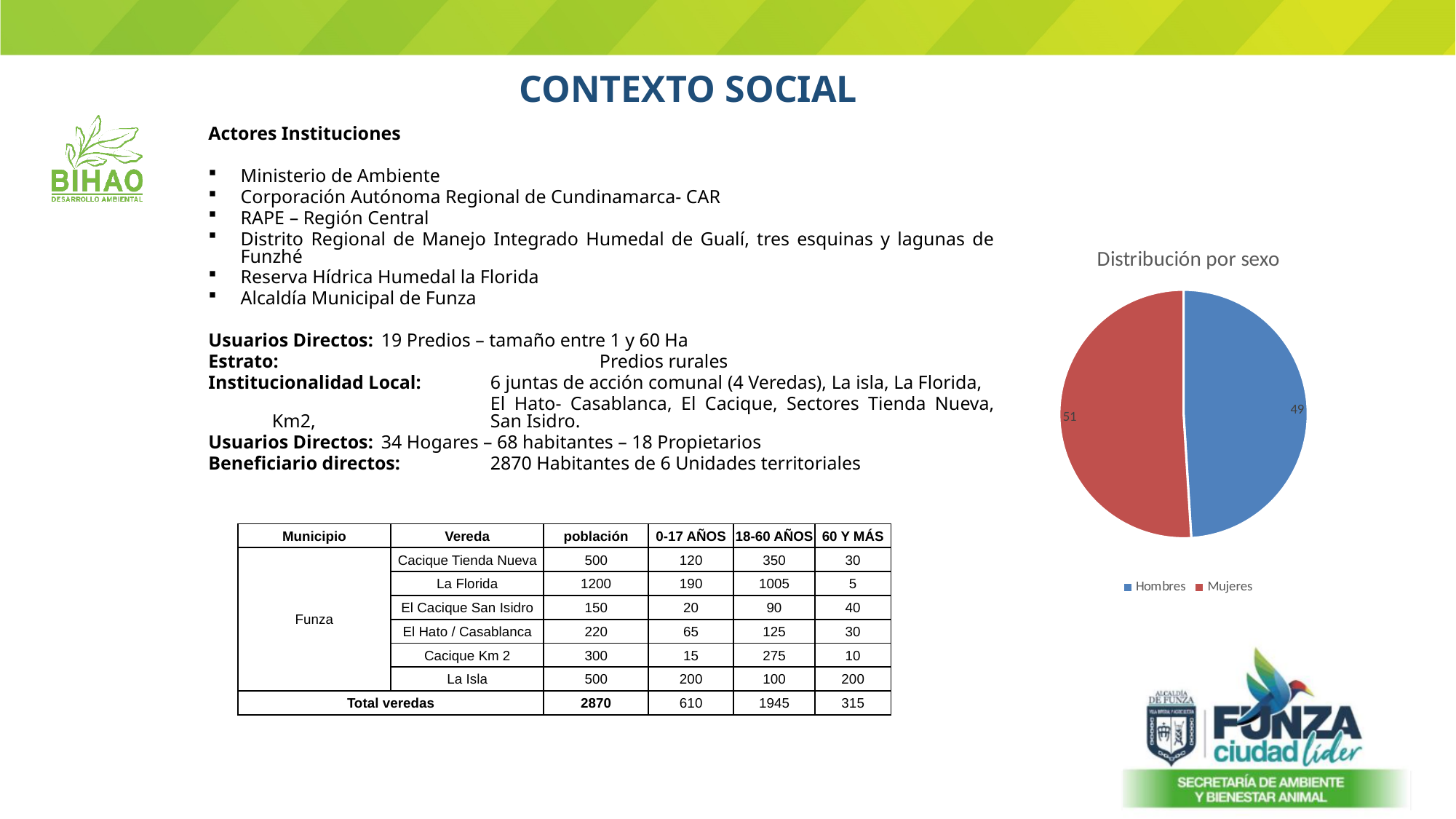
What share of the Distribución por sexo pie does the Mujeres slice represent? 51% Which category has the largest slice in the Distribución por sexo pie chart? Mujeres Which category has the smallest slice in the Distribución por sexo pie chart? Hombres What kind of chart is Distribución por sexo? pie chart How many slices does the Distribución por sexo pie chart have? 2 What is the value for Hombres in the Distribución por sexo pie chart? 49 What colour is the Hombres slice in the Distribución por sexo pie chart? blue What is the total of the two values shown in the Distribución por sexo pie chart? 100 What is the value for Mujeres in the Distribución por sexo pie chart? 51 In the Distribución por sexo chart, which is larger, Hombres or Mujeres? Mujeres What is the difference between the values for Mujeres and Hombres in the Distribución por sexo chart? 2 How many entries does the legend of the Distribución por sexo chart list? 2